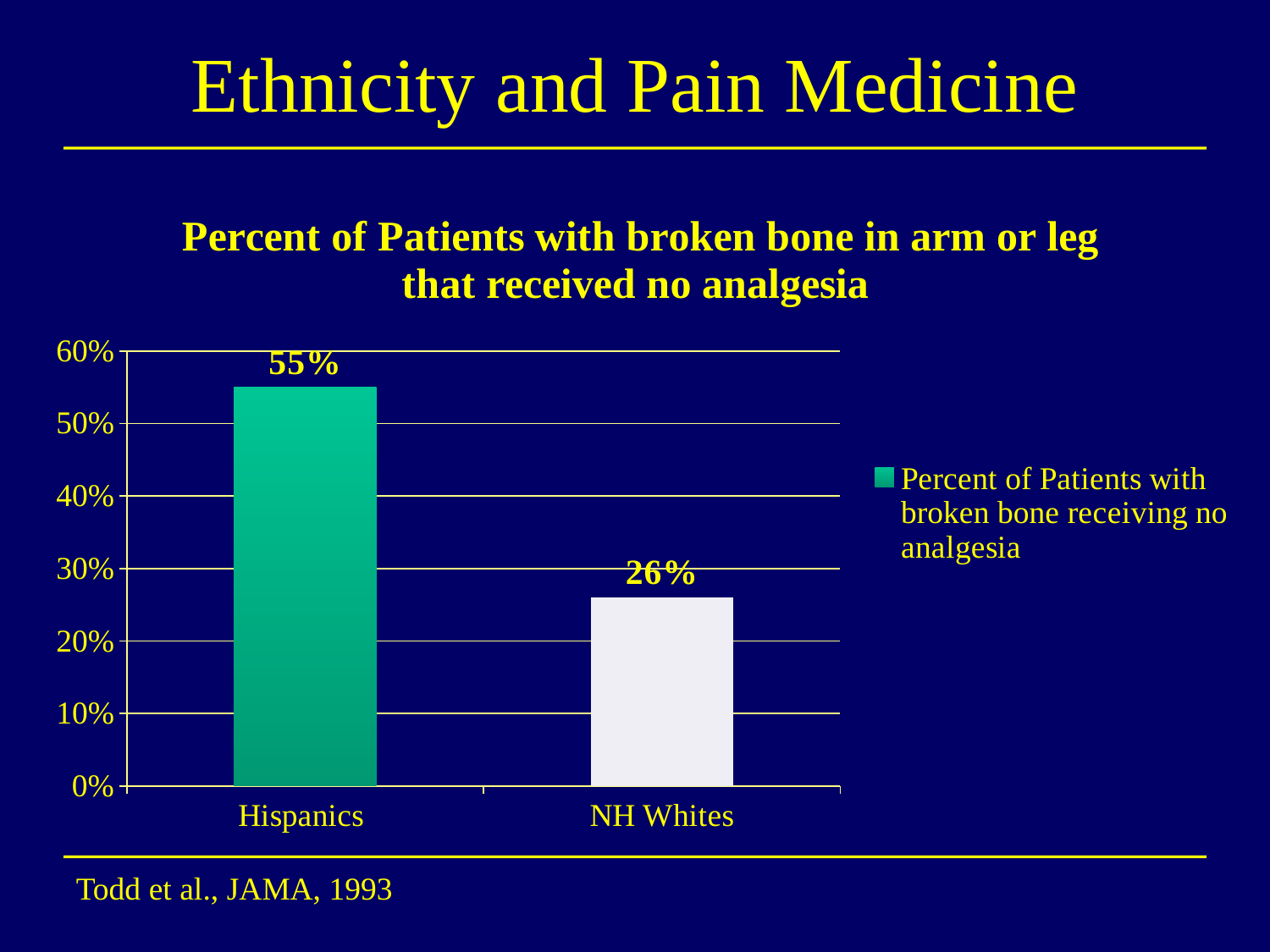
What is the highest value shown on the y axis? 60% What percent of Hispanic patients with a broken bone received no analgesia? 55% How many groups are shown on the x axis? 2 What is the title of the chart? Percent of Patients with broken bone in arm or leg that received no analgesia Which group has the higher percentage of patients receiving no analgesia? Hispanics What kind of chart is shown on the slide? bar chart What percent of NH White patients with a broken bone received no analgesia? 26% Is the value for Hispanics greater or less than 50%? greater Which group has the lower percentage of patients receiving no analgesia? NH Whites How many series does the legend list? 1 What is the difference in percentage points between Hispanics and NH Whites? 29% Is the value for NH Whites greater or less than 30%? less